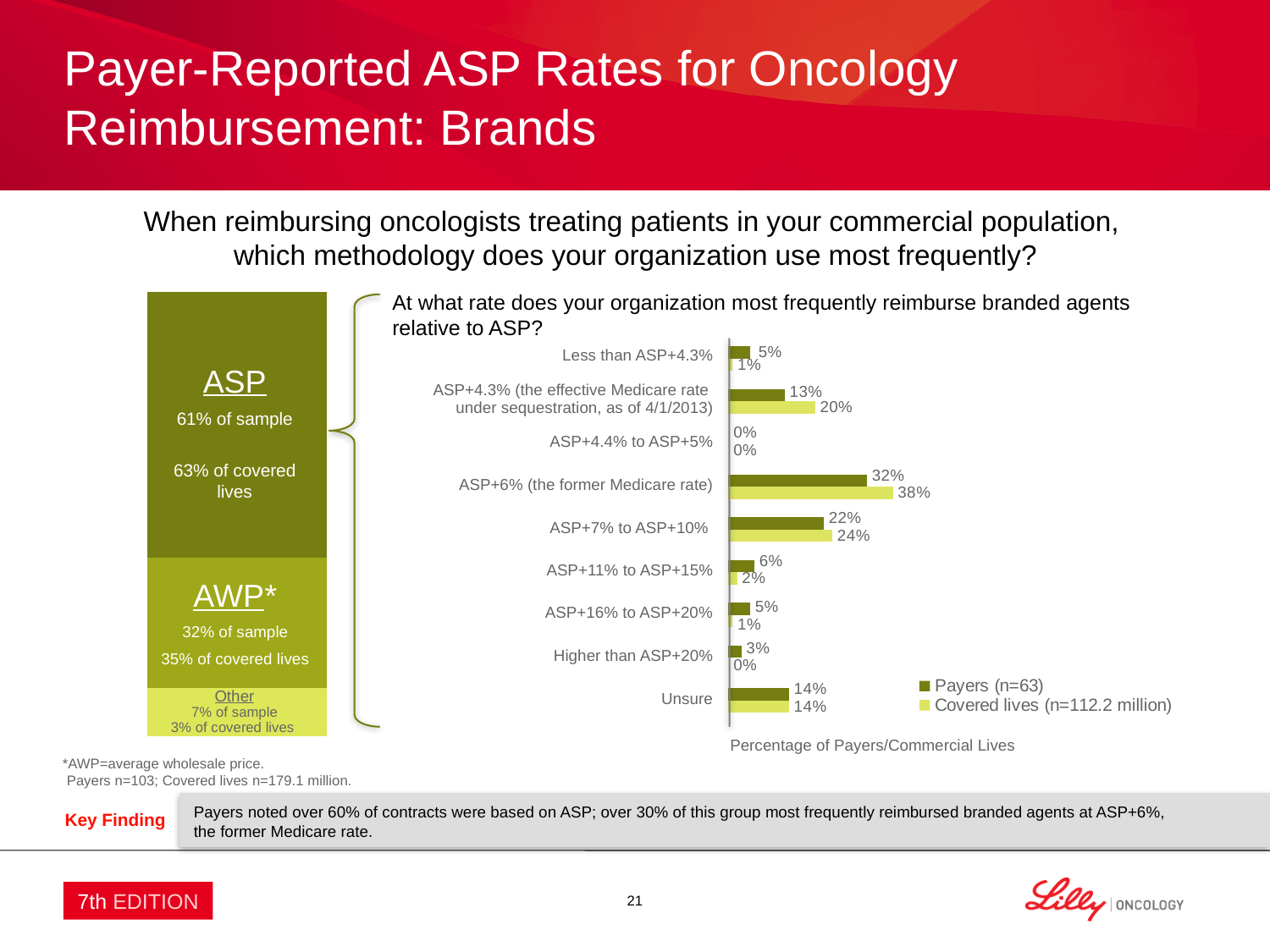
In the bar chart, what percentage of payers most frequently reimburse branded agents at ASP+6% (the former Medicare rate)? 32% In the stacked bar on the left of the slide, what percentage of the sample uses ASP? 61% of sample What are the two series named in the legend of the bar chart? Payers (n=63) and Covered lives (n=112.2 million) In the bar chart, which reimbursement rate category has the highest Payers value? ASP+6% (the former Medicare rate) How many reimbursement rate categories are shown in the bar chart? 9 In the bar chart, what is the Payers value for Unsure? 14% In the bar chart, which is larger for ASP+7% to ASP+10%: the Payers value or the Covered lives value? Covered lives In the bar chart, what is the Covered lives value for ASP+4.3% (the effective Medicare rate under sequestration, as of 4/1/2013)? 20% How many series does the legend of the bar chart list? 2 In the bar chart, what is the difference between the Covered lives value and the Payers value for ASP+6% (the former Medicare rate)? 6% What type of chart is used to show the rates at which organizations reimburse branded agents relative to ASP? Bar chart